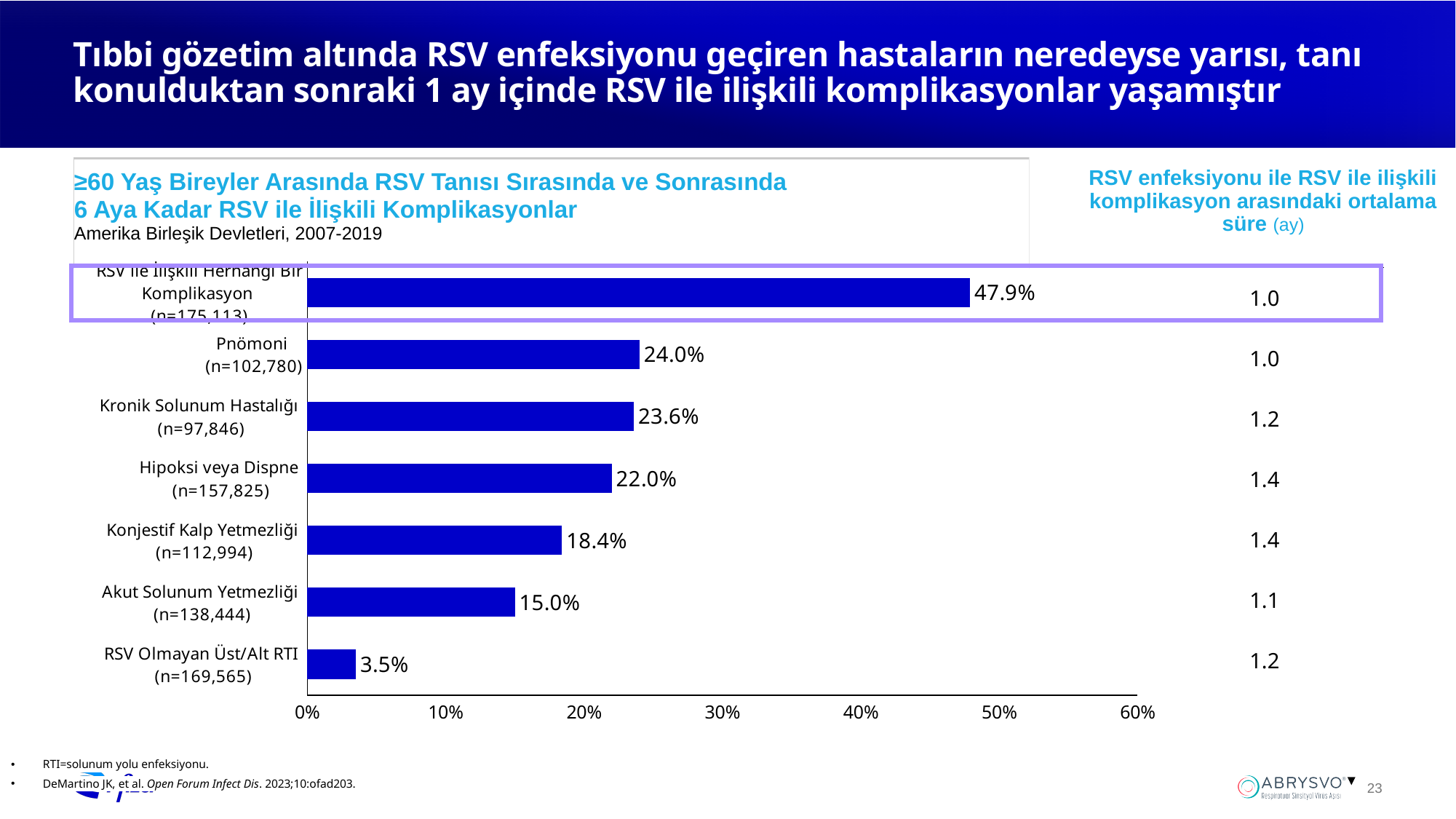
What is the difference between the percentages for Pnömoni and Akut Solunum Yetmezliği? 9.0% What percentage is shown for RSV Olmayan Üst/Alt RTI? 3.5% Which category has the lowest percentage? RSV Olmayan Üst/Alt RTI What is the maximum value shown on the percentage axis? 60% What is the value for Konjestif Kalp Yetmezliği? 18.4% Which category has the highest percentage? RSV ile İlişkili Herhangi Bir Komplikasyon Is the value for Kronik Solunum Hastalığı greater or less than 20%? greater Do the bar values increase or decrease from the top category to the bottom category? decrease Which is larger, the value for Hipoksi veya Dispne or the value for Konjestif Kalp Yetmezliği? Hipoksi veya Dispne How many categories are plotted in the chart? 7 What kind of chart is shown on the slide? bar chart What percentage is shown for Pnömoni? 24.0%